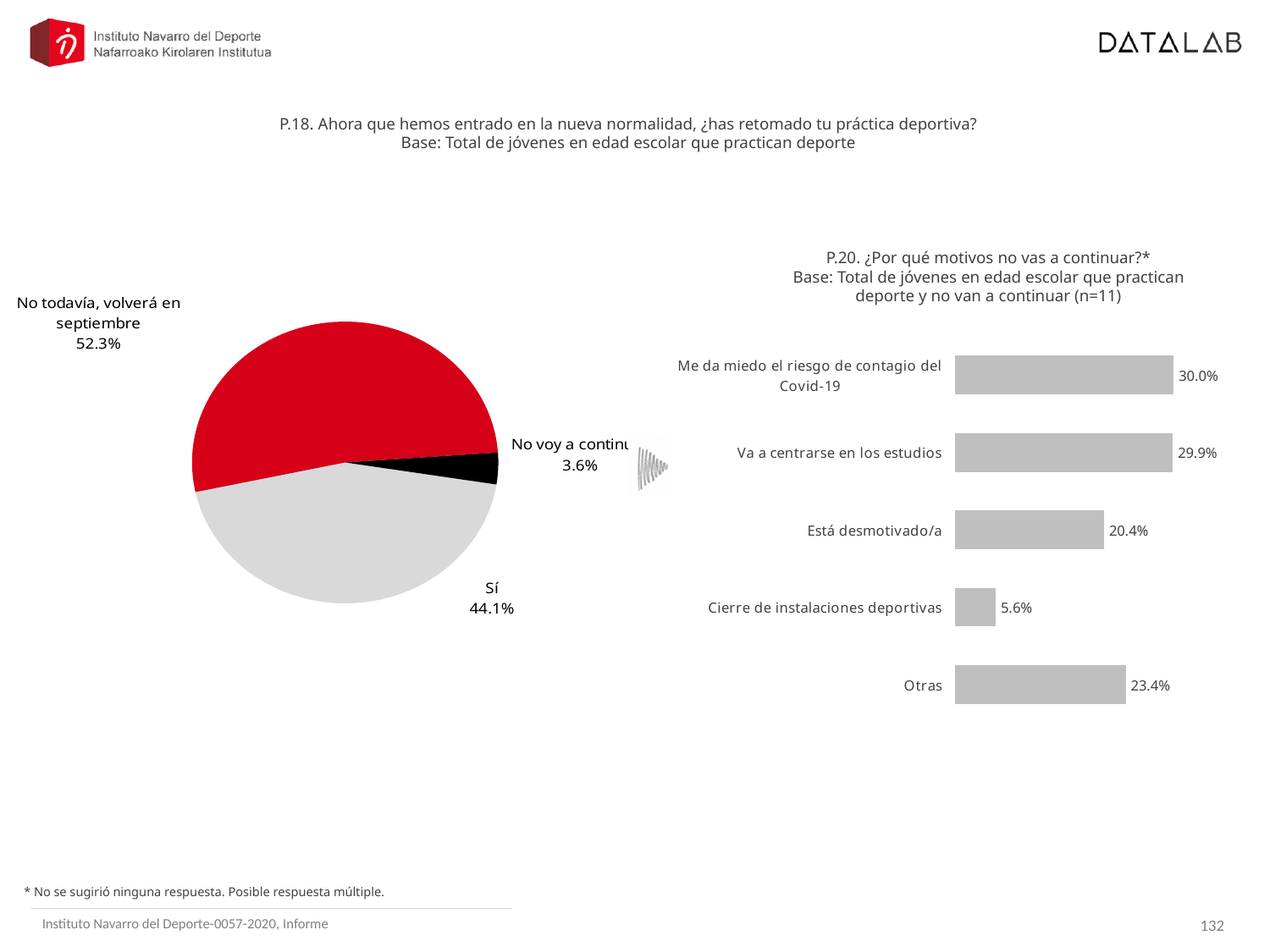
In the bar chart on the right (P.20), how many categories are shown? 5 In the bar chart on the right (P.20), which is larger: "Otras" or "Está desmotivado/a"? Otras In the pie chart on the left (P.18), which category has the largest slice? No todavía, volverá en septiembre What type of chart is used for P.20 on the right side of the slide? Bar chart In the pie chart on the left (P.18), what share corresponds to "No todavía, volverá en septiembre"? 52.3% In the bar chart on the right (P.20), what is the value for "Cierre de instalaciones deportivas"? 5.6% In the pie chart on the left (P.18), how many slices are there? 3 In the bar chart on the right (P.20), what is the value for "Está desmotivado/a"? 20.4% In the bar chart on the right (P.20), which category has the lowest value? Cierre de instalaciones deportivas In the pie chart on the left (P.18), what is the share of the smallest slice? 3.6% In the pie chart on the left (P.18), what is the difference between "No todavía, volverá en septiembre" and "Sí"? 8.2 percentage points In the pie chart on the left (P.18), what share of respondents answered "Sí"? 44.1%